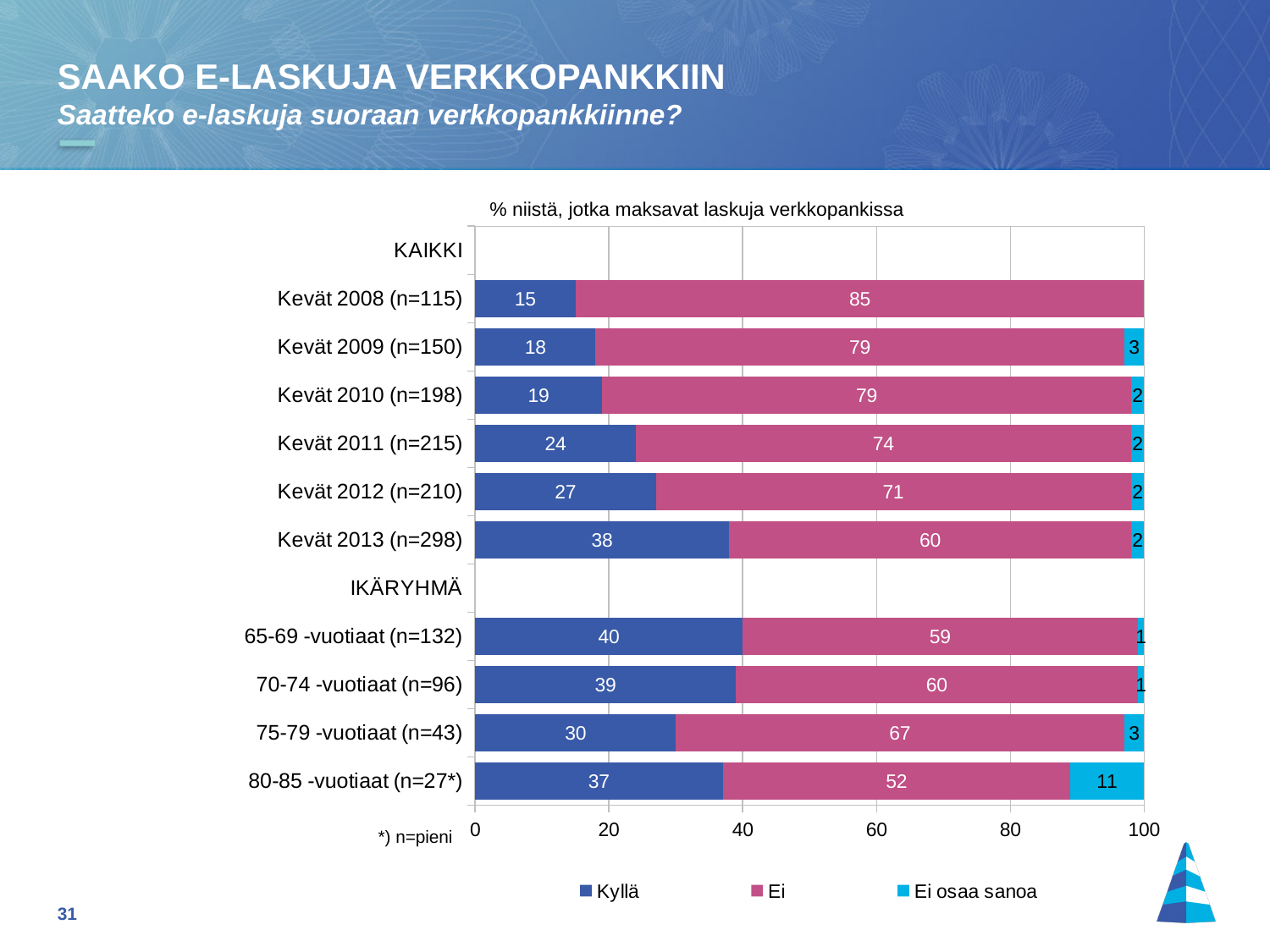
What is the subtitle printed above the chart? % niistä, jotka maksavat laskuja verkkopankissa Which is larger: the "Ei" value for 75-79 -vuotiaat (n=43) or for 80-85 -vuotiaat (n=27*)? 75-79 -vuotiaat (n=43) What is the total of the stacked bar for 80-85 -vuotiaat (n=27*)? 100 Do the "Kyllä" values rise or fall from Kevät 2008 to Kevät 2013? Rise What is the "Ei" value for Kevät 2008 (n=115)? 85 What is the difference between the "Kyllä" values for Kevät 2013 (n=298) and Kevät 2008 (n=115)? 23 How many series does the legend list? 3 What kind of chart is shown on the slide? Stacked bar chart What is the "Kyllä" value for Kevät 2013 (n=298)? 38 Which category has the highest "Kyllä" value? 65-69 -vuotiaat (n=132) What is the "Ei osaa sanoa" value for 80-85 -vuotiaat (n=27*)? 11 Which category has the lowest "Kyllä" value? Kevät 2008 (n=115)